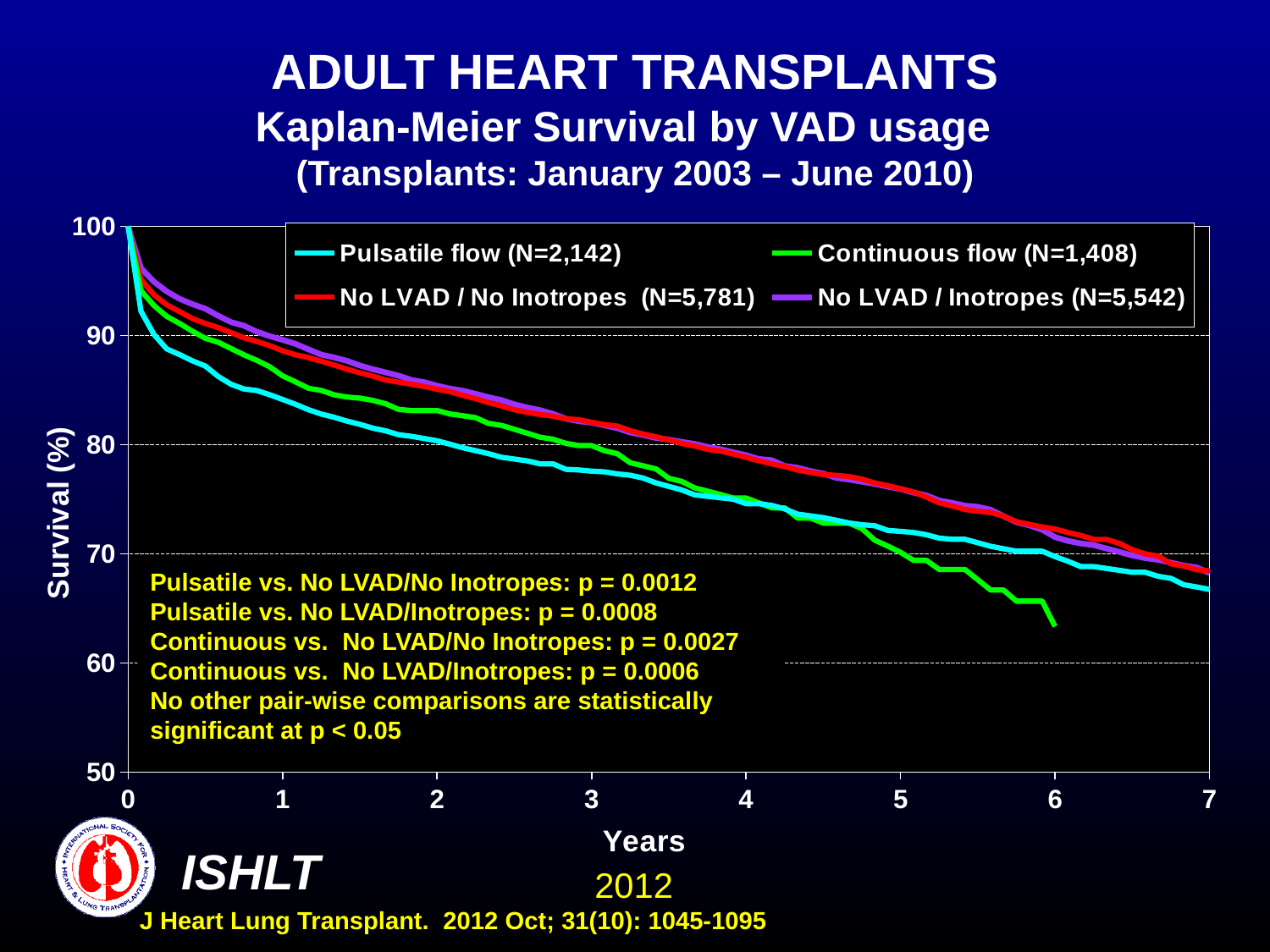
Do the survival curves rise or fall as years increase? fall How many series does the legend list? 4 Is the survival value for Continuous flow at 6 years greater or less than 70? less Which series is drawn in green? Continuous flow (N=1,408) What is the N for the Pulsatile flow group shown in the legend? N=2,142 Is the survival value for Pulsatile flow at 7 years greater or less than 70? less At 1 year, which is higher: Pulsatile flow or No LVAD / No Inotropes? No LVAD / No Inotropes Is the survival value for No LVAD / No Inotropes at 3 years greater or less than 80? greater What kind of chart is shown on the slide? line chart At 1 year, which series has the lowest survival? Pulsatile flow